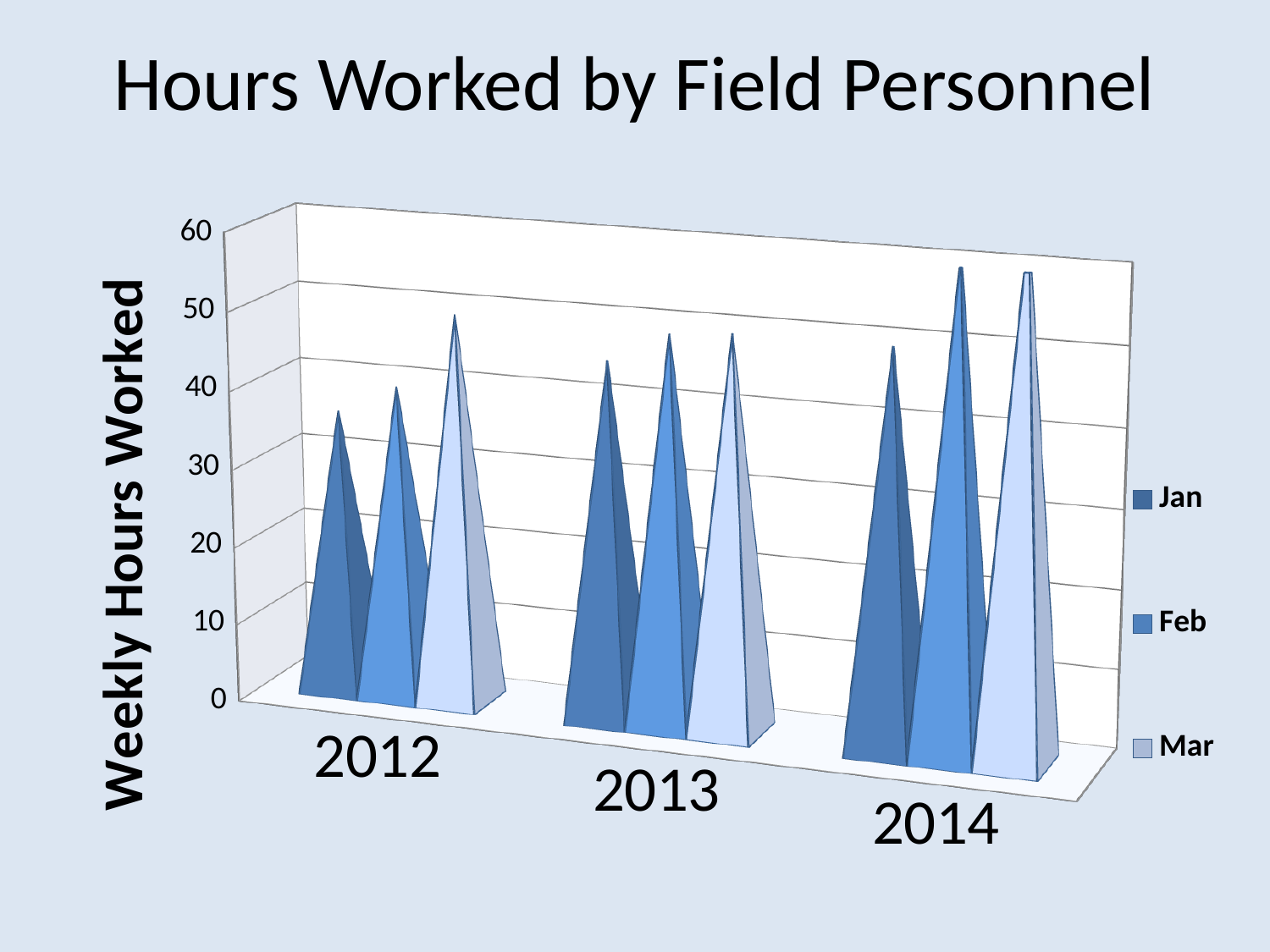
How many series does the chart's legend list? 3 What kind of chart is shown on the slide? bar chart Is the value for Feb in 2014 greater or less than 50? greater Which month has the highest value in 2012? Mar Which is larger, the Feb value for 2012 or the Feb value for 2014? 2014 How many years are shown on the x axis of the chart? 3 Is the value for Mar in 2012 greater or less than 40? greater Is the value for Jan in 2012 greater or less than 30? greater What is the label on the vertical axis of the chart? Weekly Hours Worked Do the Jan values rise or fall from 2012 to 2014? rise What is the title of the chart? Hours Worked by Field Personnel